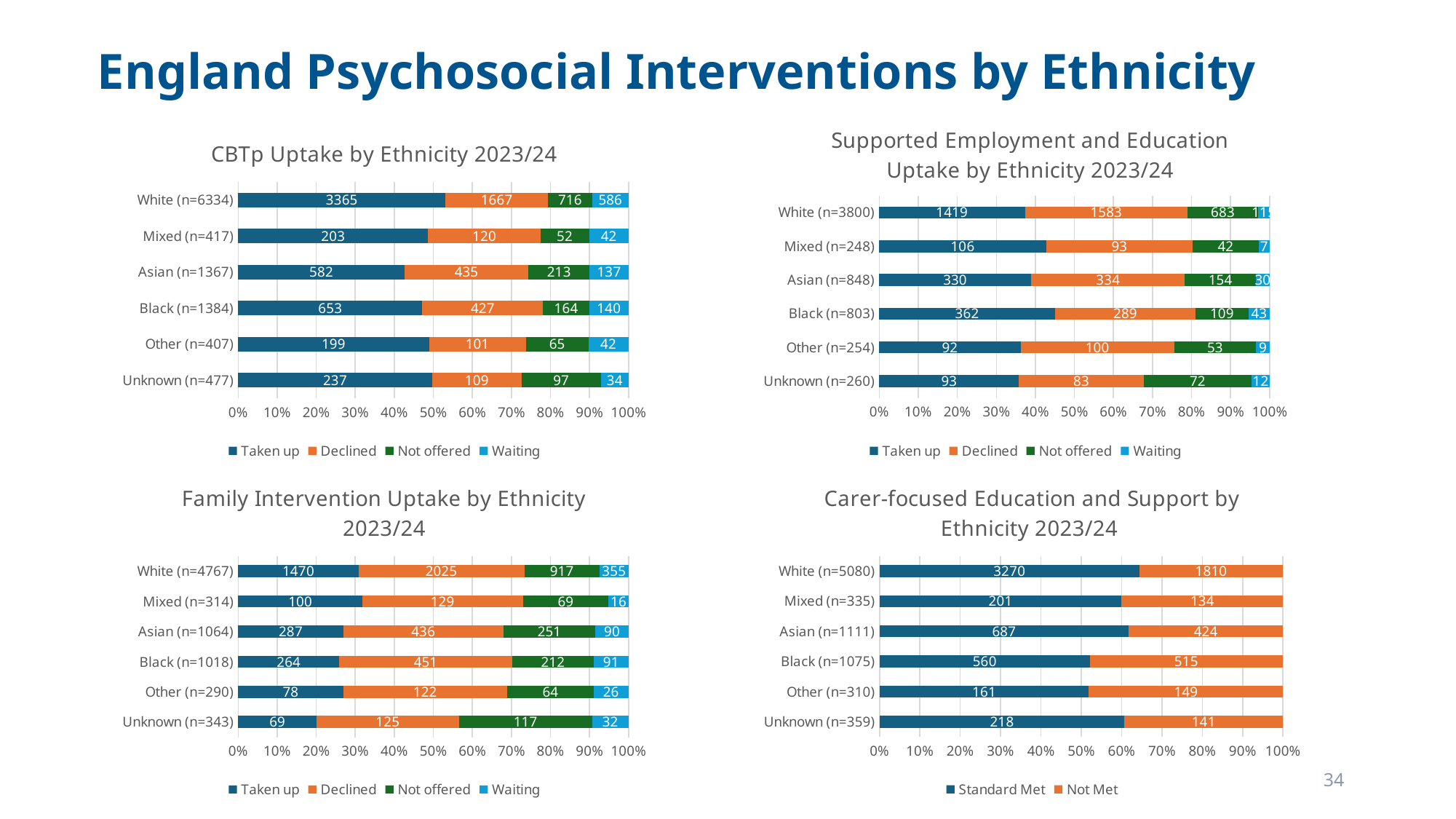
In the Supported Employment and Education Uptake by Ethnicity 2023/24 chart, what is the Declined value for Asian (n=848)? 334 In the Family Intervention Uptake by Ethnicity 2023/24 chart, what is the total of all four segments for Other (n=290)? 290 In the Carer-focused Education and Support by Ethnicity 2023/24 chart, does the Standard Met segment for White (n=5080) end at a percentage greater or less than 60%? greater In the CBTp Uptake by Ethnicity 2023/24 chart, what is the Taken up value for Black (n=1384)? 653 What kind of chart is the Family Intervention Uptake by Ethnicity 2023/24 chart? Stacked bar chart In the Carer-focused Education and Support by Ethnicity 2023/24 chart, how much larger is Standard Met than Not Met for Black (n=1075)? 45 In the Carer-focused Education and Support by Ethnicity 2023/24 chart, which category has the highest Standard Met value? White (n=5080) How many ethnicity categories are shown in the Carer-focused Education and Support by Ethnicity 2023/24 chart? 6 How many series does the legend of the CBTp Uptake by Ethnicity 2023/24 chart list? 4 In the Carer-focused Education and Support by Ethnicity 2023/24 chart, what is the Not Met value for White (n=5080)? 1810 In the CBTp Uptake by Ethnicity 2023/24 chart, which has the larger Taken up value, Asian or Black? Black In the Family Intervention Uptake by Ethnicity 2023/24 chart, what is the Not offered value for Unknown (n=343)? 117